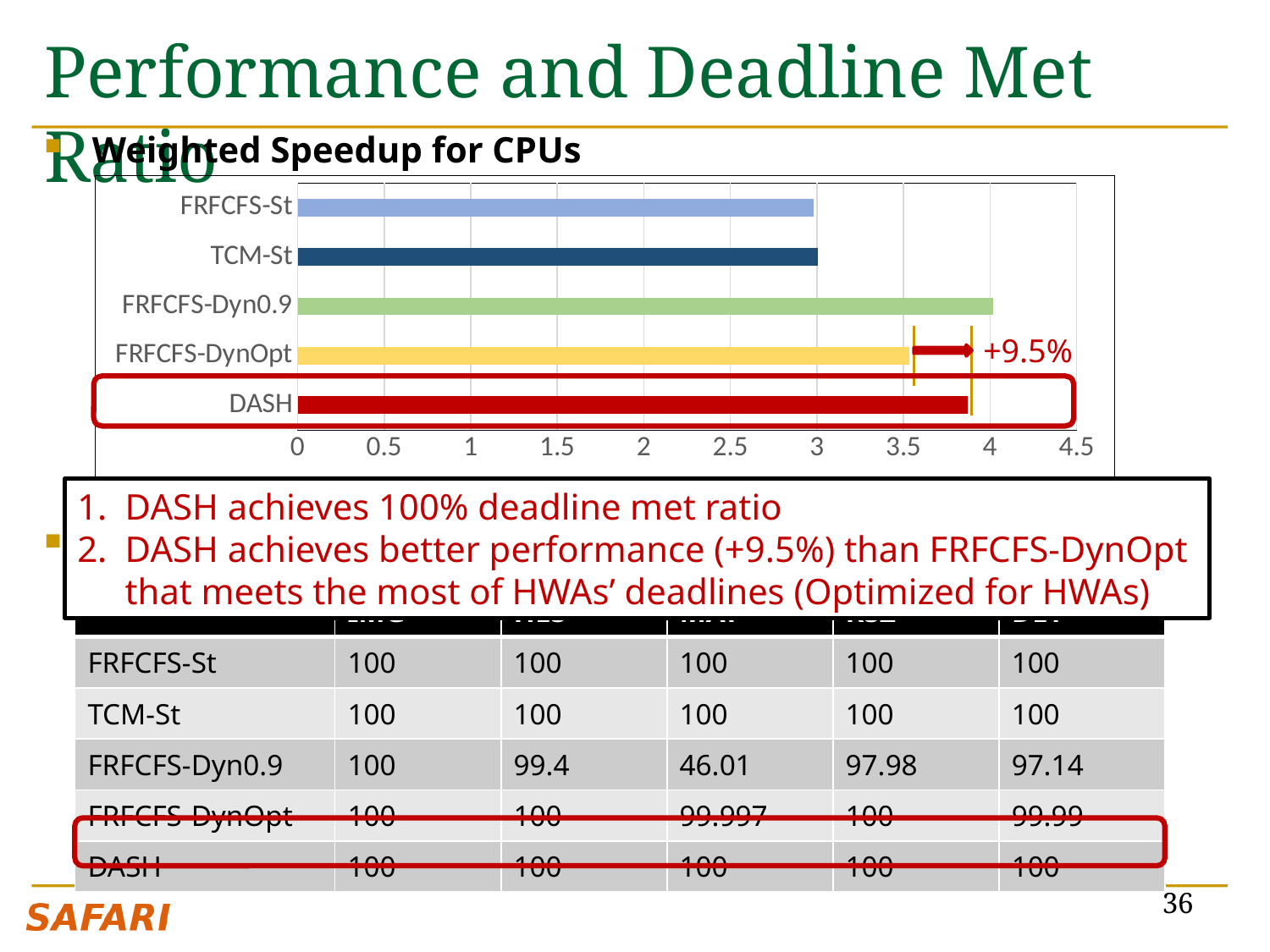
Which scheme has the highest weighted speedup in the Weighted Speedup for CPUs chart? FRFCFS-Dyn0.9 Is the weighted speedup for DASH greater or less than 3.5? greater Is the weighted speedup for FRFCFS-Dyn0.9 greater or less than 3.5? greater What percentage improvement is annotated on the chart between DASH and FRFCFS-DynOpt? +9.5% What is the highest value shown on the x axis of the Weighted Speedup for CPUs chart? 4.5 Is the weighted speedup for FRFCFS-DynOpt greater or less than 4? less In the Weighted Speedup for CPUs chart, which has the larger weighted speedup, FRFCFS-Dyn0.9 or DASH? FRFCFS-Dyn0.9 In the Weighted Speedup for CPUs chart, which has the larger weighted speedup, TCM-St or FRFCFS-DynOpt? FRFCFS-DynOpt In the Weighted Speedup for CPUs chart, which has the larger weighted speedup, DASH or FRFCFS-DynOpt? DASH How many scheduling schemes (bars) are plotted in the Weighted Speedup for CPUs chart? 5 What kind of chart is shown under the heading "Weighted Speedup for CPUs"? bar chart